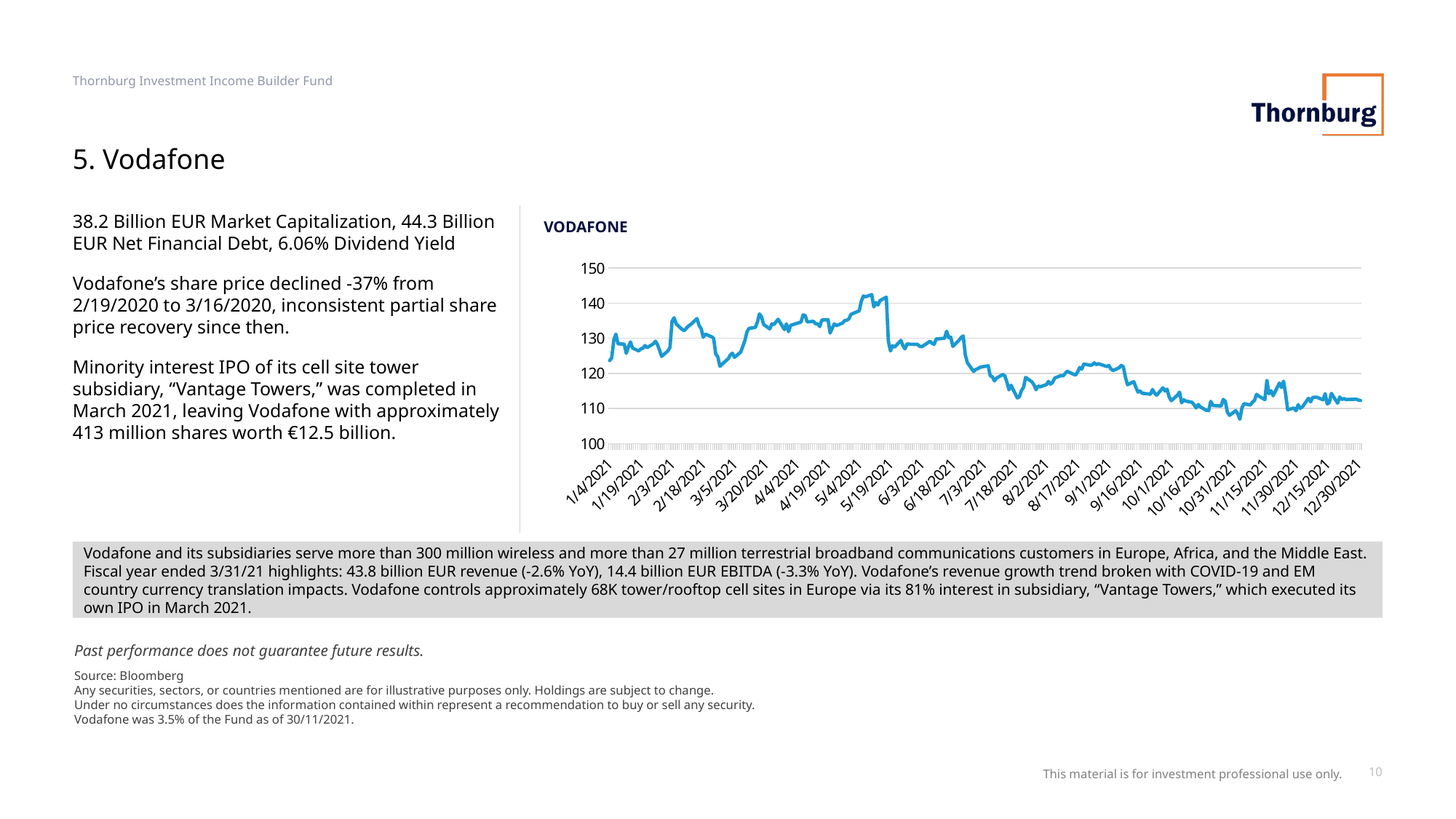
In which month does the line reach its highest point? May 2021 What is the title of the chart? VODAFONE Does the line overall rise or fall from 1/4/2021 to 12/30/2021? fall Is the value around 10/31/2021 greater or less than 110? less Is the value at the end of the chart (12/30/2021) greater or less than 120? less Is the value around 4/19/2021 greater or less than 130? greater What kind of chart is shown on the slide? line chart What is the range of the vertical axis on the chart? 100 to 150 Does the line rise or fall between 5/19/2021 and 7/18/2021? fall